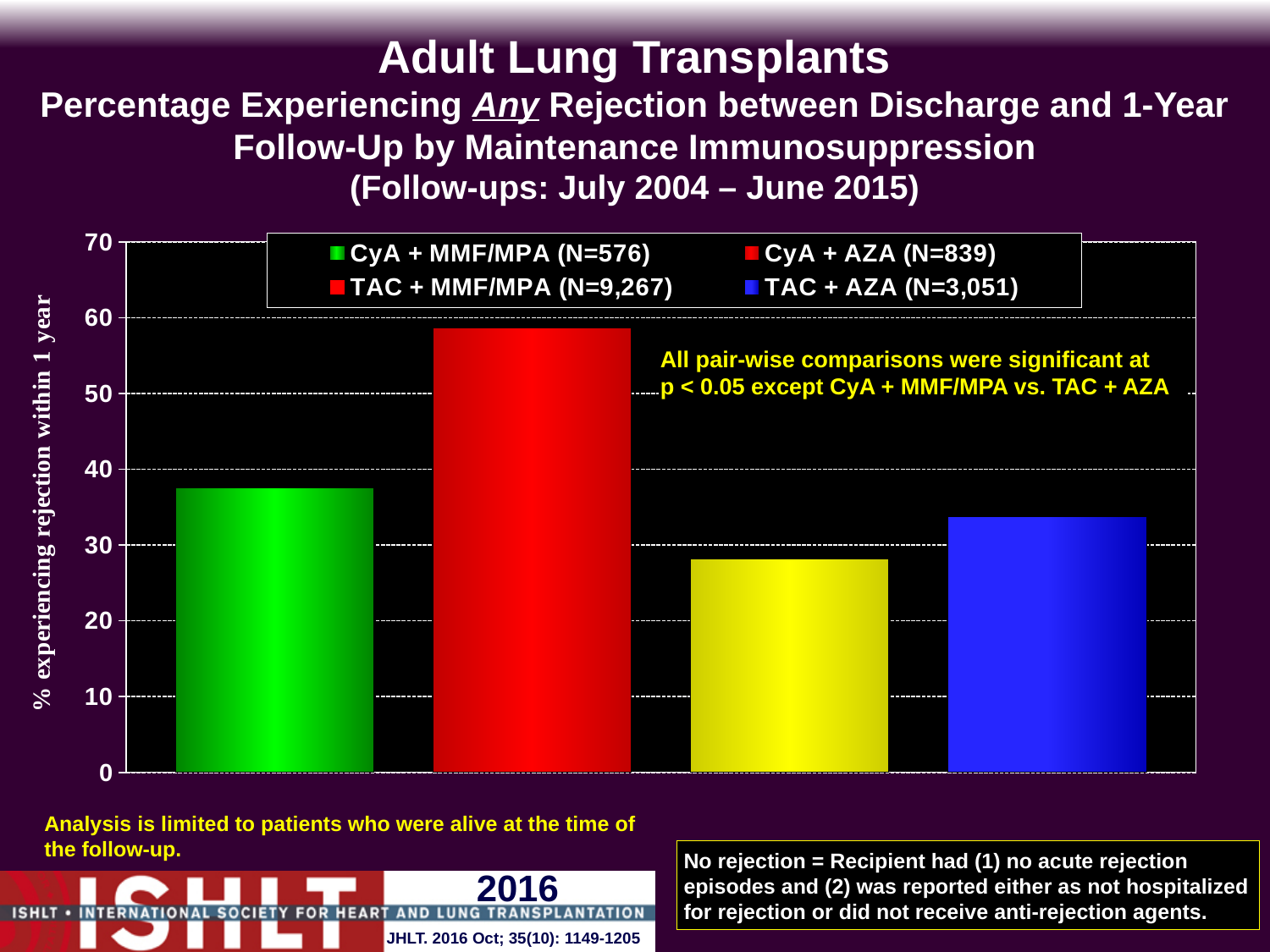
What kind of chart is shown on the slide? bar chart How many bars are plotted in the chart? 4 Which is larger, the value for CyA + MMF/MPA or the value for TAC + AZA? CyA + MMF/MPA Which maintenance immunosuppression group has the highest percentage experiencing rejection within 1 year? CyA + AZA Which is larger, the value for CyA + AZA or the value for TAC + MMF/MPA? CyA + AZA Which maintenance immunosuppression group has the lowest percentage experiencing rejection within 1 year? TAC + MMF/MPA What is the N reported in the legend for the TAC + MMF/MPA group? 9,267 How many series does the legend list? 4 Is the value for CyA + AZA greater or less than 50? greater Is the value for TAC + AZA greater or less than 30? greater Is the value for TAC + MMF/MPA greater or less than 30? less